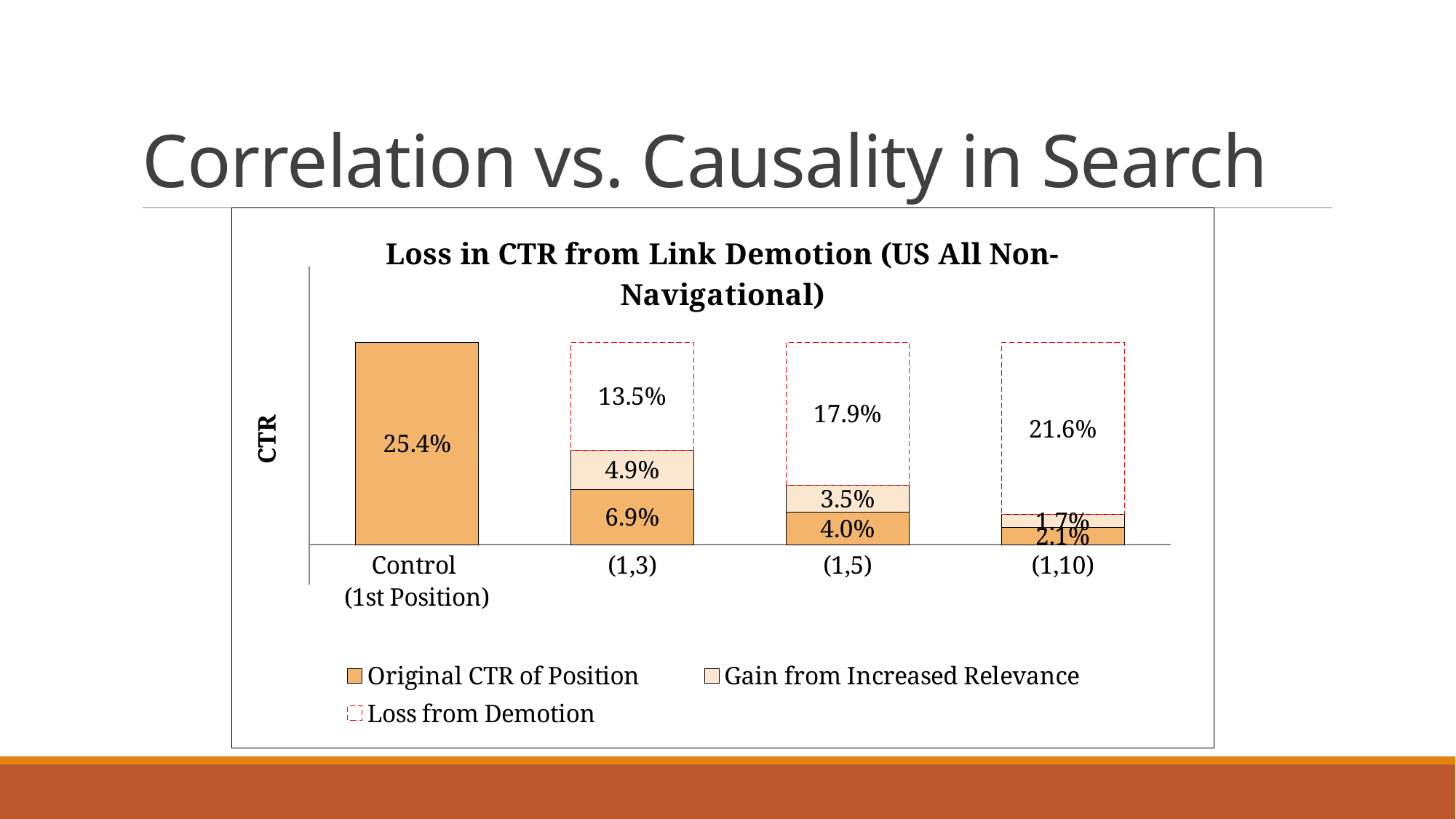
Which is larger: the Original CTR of Position for (1,3) or for (1,5)? (1,3) What is the difference between the Loss from Demotion values for (1,10) and (1,3)? 8.1% What is the Original CTR of Position value for the (1,10) category? 2.1% What is the Gain from Increased Relevance value for the (1,3) category? 4.9% What is the total of the stacked bar for the (1,5) category? 25.4% What is the Original CTR of Position value for the Control (1st Position) category? 25.4% Which category has the highest Loss from Demotion value? (1,10) How many series does the legend list? 3 How many categories are shown on the x axis? 4 What is the Loss from Demotion value for the (1,5) category? 17.9% What kind of chart is shown on the slide? Stacked bar chart